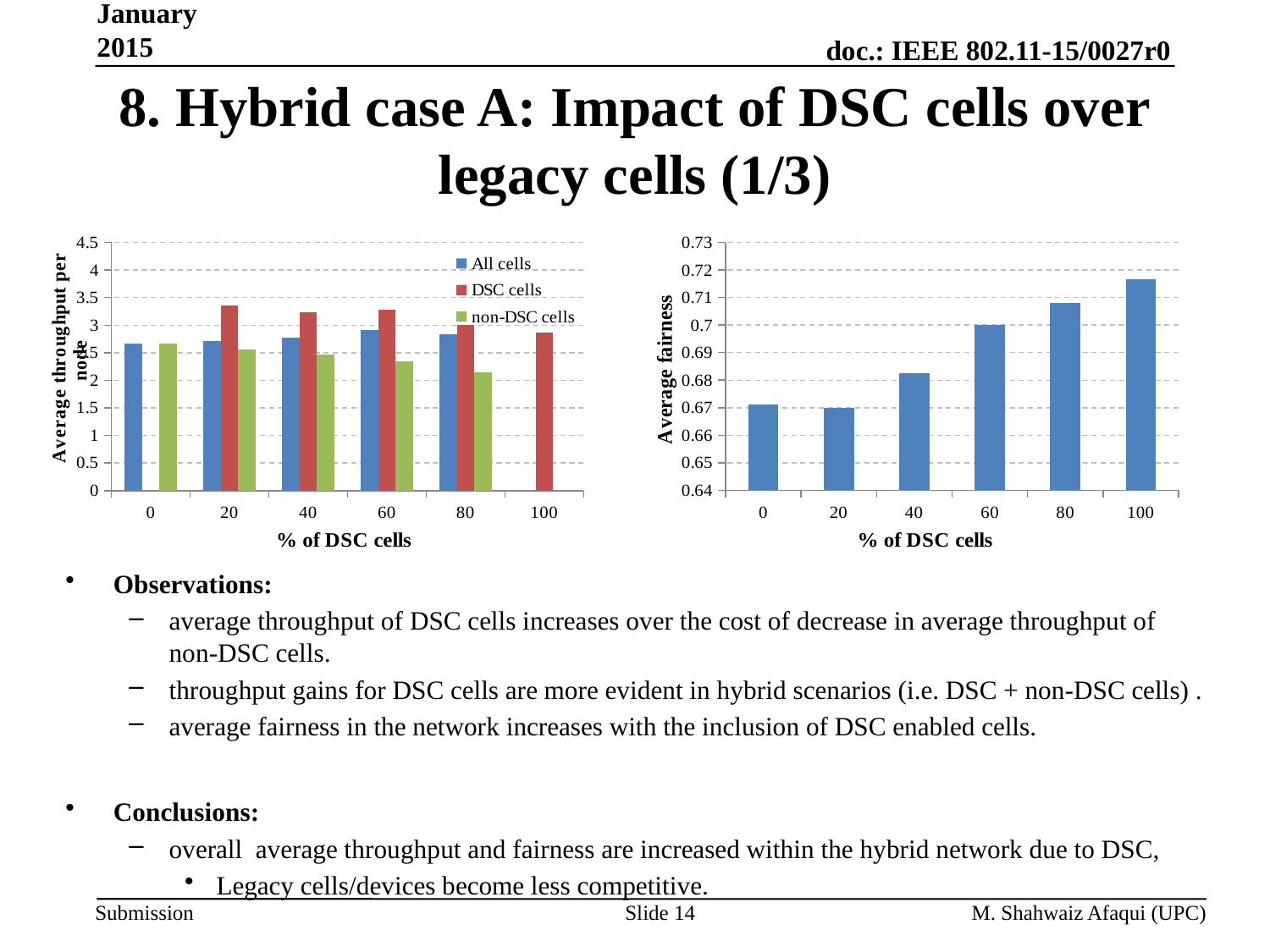
How many series does the legend of the left-hand chart (Average throughput per node) list? 3 In the left-hand chart (Average throughput per node), is the non-DSC cells value at 80% of DSC cells greater or less than 2.5? less What is the x-axis title of the left-hand chart? % of DSC cells In the right-hand chart (Average fairness), which has the larger average fairness: 40% or 80% of DSC cells? 80 In the left-hand chart (Average throughput per node), which series has the highest bar at 20% of DSC cells? DSC cells In the right-hand chart (Average fairness), which % of DSC cells has the highest average fairness? 100 In the right-hand chart (Average fairness), is the value for 60% of DSC cells greater or less than 0.69? greater In the right-hand chart (Average fairness), do the values generally rise or fall as the % of DSC cells increases? rise In the left-hand chart (Average throughput per node), do the non-DSC cells values rise or fall as the % of DSC cells increases? fall In the right-hand chart (Average fairness), is the value for 0% of DSC cells greater or less than 0.68? less What kind of chart is the right-hand chart (Average fairness)? bar chart In the right-hand chart (Average fairness), how many categories are shown on the x axis? 6